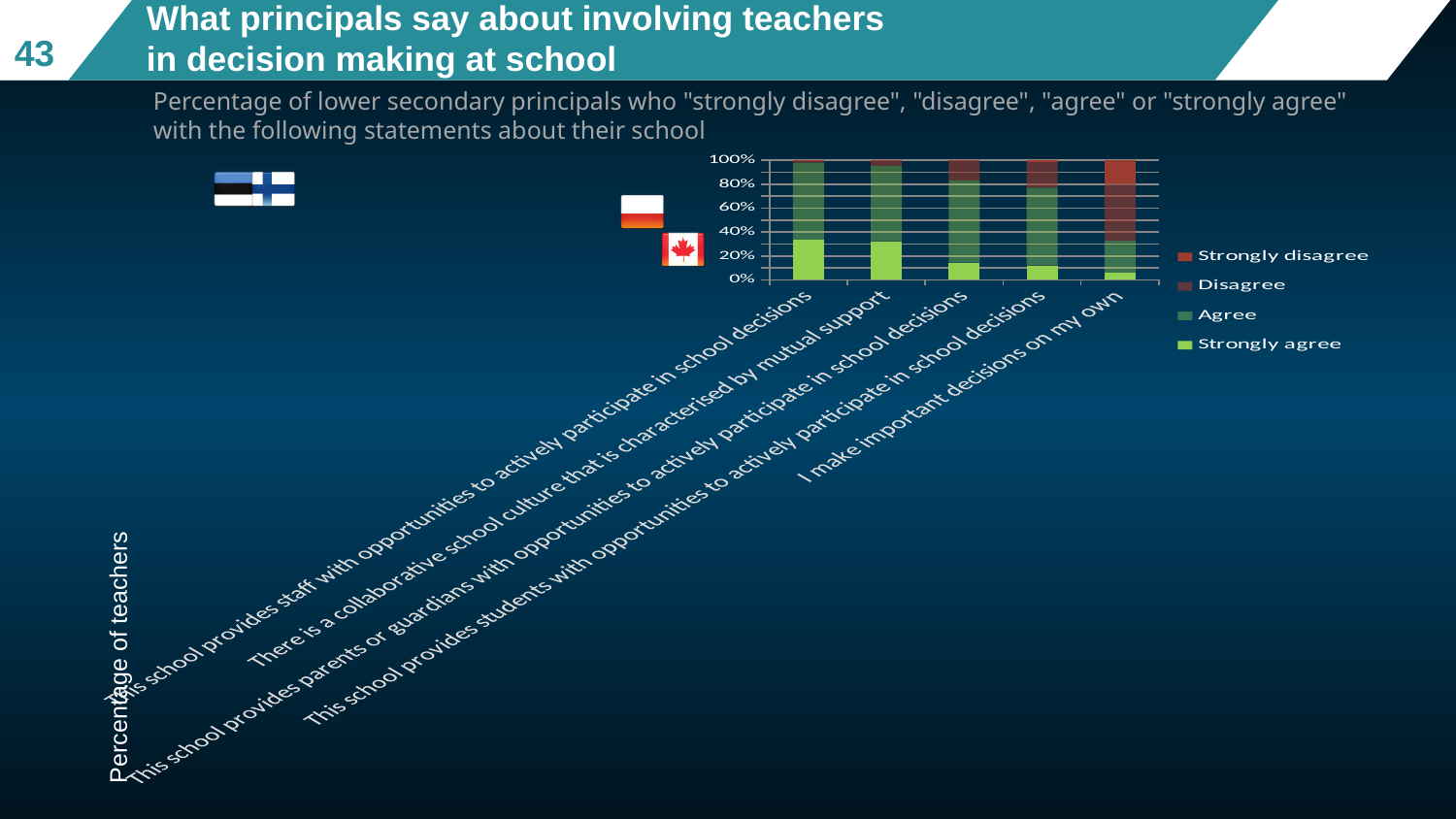
Is the 'Strongly agree' value for 'This school provides students with opportunities to actively participate in school decisions' greater or less than 20%? less Which has a larger 'Strongly agree' share: 'This school provides staff with opportunities to actively participate in school decisions' or 'I make important decisions on my own'? This school provides staff with opportunities to actively participate in school decisions Which series is listed last in the chart's legend? Strongly agree Which category has the lowest 'Strongly agree' share? I make important decisions on my own Is the 'Strongly agree' value for 'This school provides staff with opportunities to actively participate in school decisions' greater or less than 20%? greater How many statements (categories) are plotted on the x axis of the chart? 5 Does the 'Strongly agree' share rise or fall moving from left to right along the x axis? Fall What kind of chart is shown on the slide? Stacked bar chart Is the 'Strongly agree' value for 'I make important decisions on my own' greater or less than 20%? less What is the highest value shown on the chart's vertical axis? 100% How many series does the chart's legend list? 4 Which category has the largest 'Strongly disagree' share? I make important decisions on my own